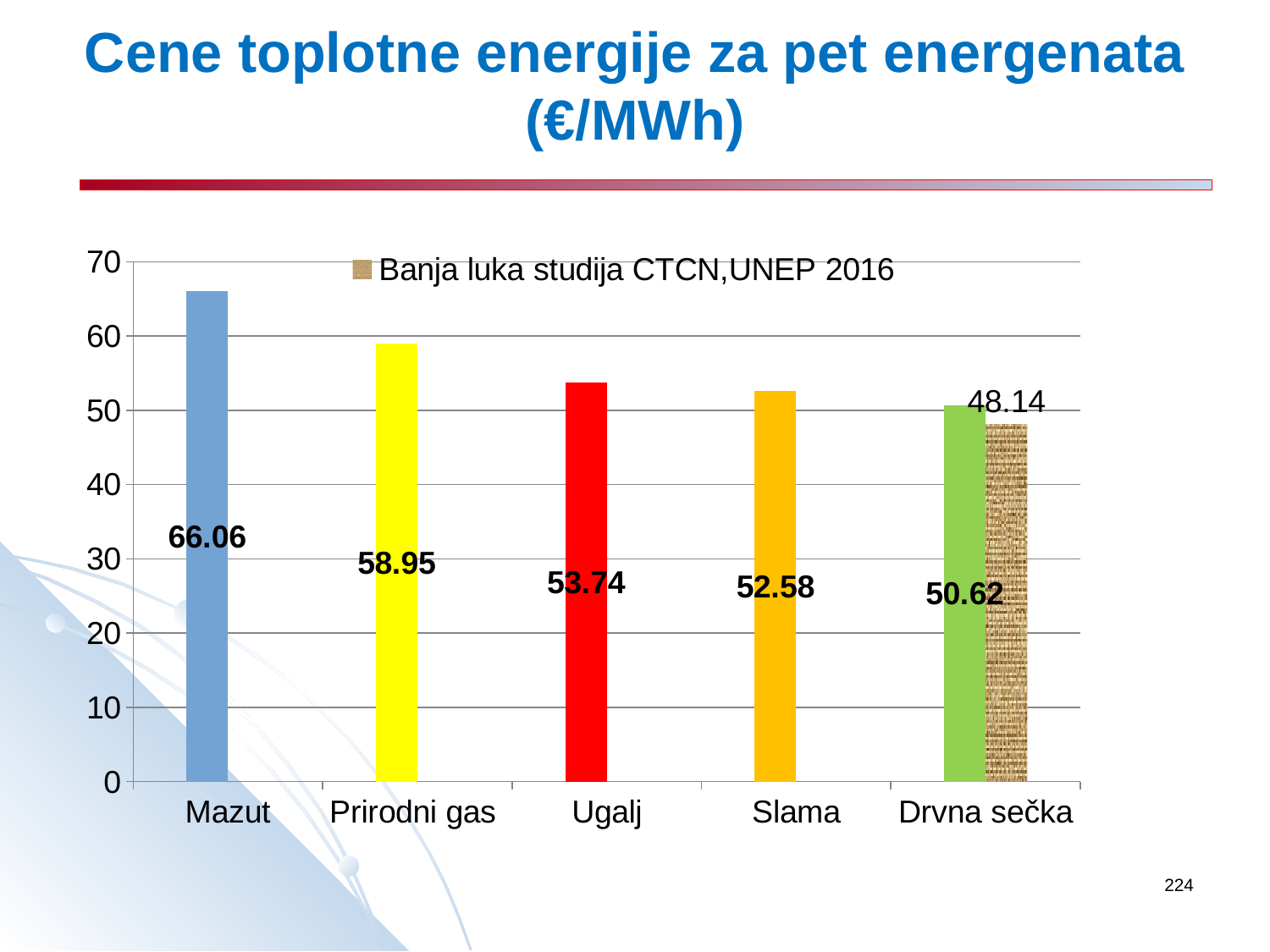
What is the difference between the values for Mazut and Prirodni gas? 7.11 Which is larger, the value for Ugalj or the value for Slama? Ugalj What is the value for Prirodni gas? 58.95 What kind of chart is shown on the slide? Bar chart How many categories are shown on the x axis? 5 What is the value for Mazut? 66.06 Which category has the lowest value among the five coloured bars? Drvna sečka What is the value for Ugalj? 53.74 What is the title of the slide? Cene toplotne energije za pet energenata (€/MWh) What is the value for Slama? 52.58 What is the value labelled on the Banja luka studija CTCN,UNEP 2016 bar for Drvna sečka? 48.14 Which category has the highest value? Mazut